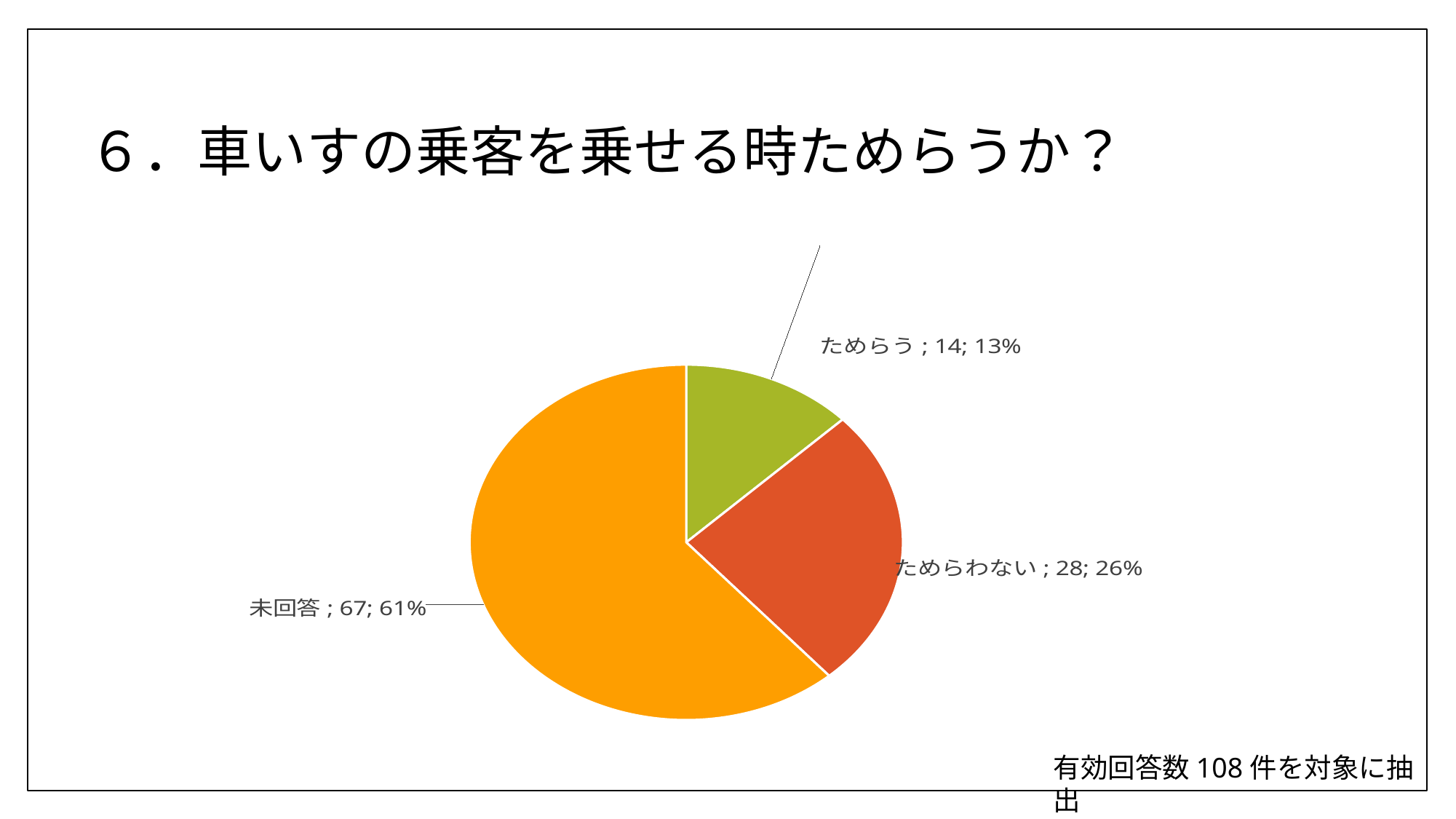
How many slices does the pie chart have? 3 What is the count for ためらわない? 28 Which category has the smallest slice? ためらう What colour is the 未回答 slice? orange Which category has the largest slice? 未回答 Which is larger, the count for ためらわない or the count for ためらう? ためらわない What percentage share does 未回答 have? 61% What is the count for 未回答? 67 What is the difference in count between ためらわない and ためらう? 14 What percentage share does ためらう have? 13% What is the count for ためらう? 14 What kind of chart is shown on the slide? pie chart